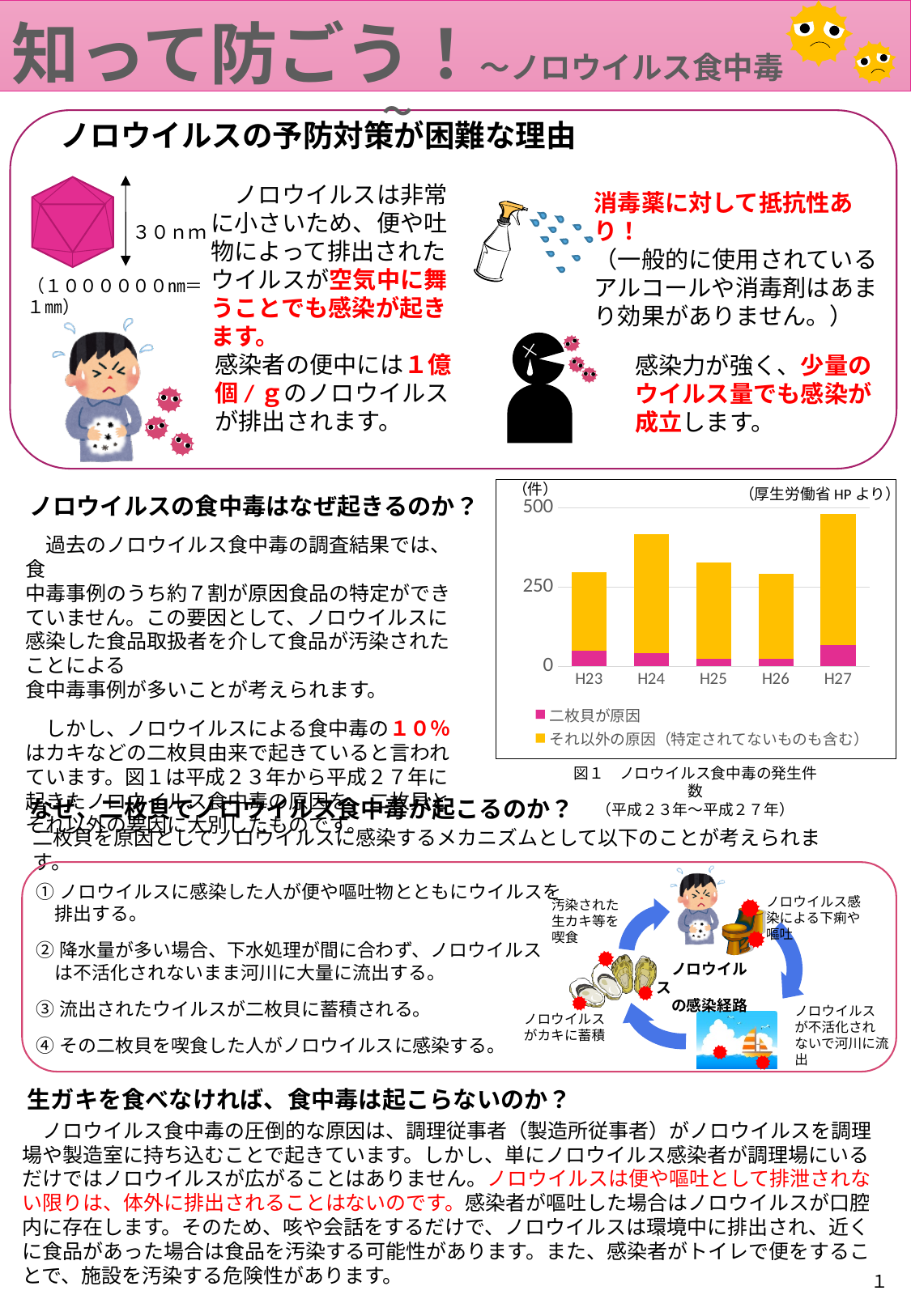
Which has a larger total number of cases, H27 or H23? H27 What is the unit shown on the y axis of the chart? 件 Which year has the largest value for the 二枚貝が原因 series? H27 Is the total value for H24 greater or less than 250? greater Which colour represents the 二枚貝が原因 series in the chart? pink Which has a larger total number of cases, H24 or H25? H24 How many series does the chart's legend list? 2 How many categories (years) are shown on the x axis of the chart? 5 Is the total value for H27 greater or less than 500? less What kind of chart is shown on the slide? stacked bar chart Which year has the highest total number of cases in the chart? H27 Is the total value for H23 greater or less than 250? greater